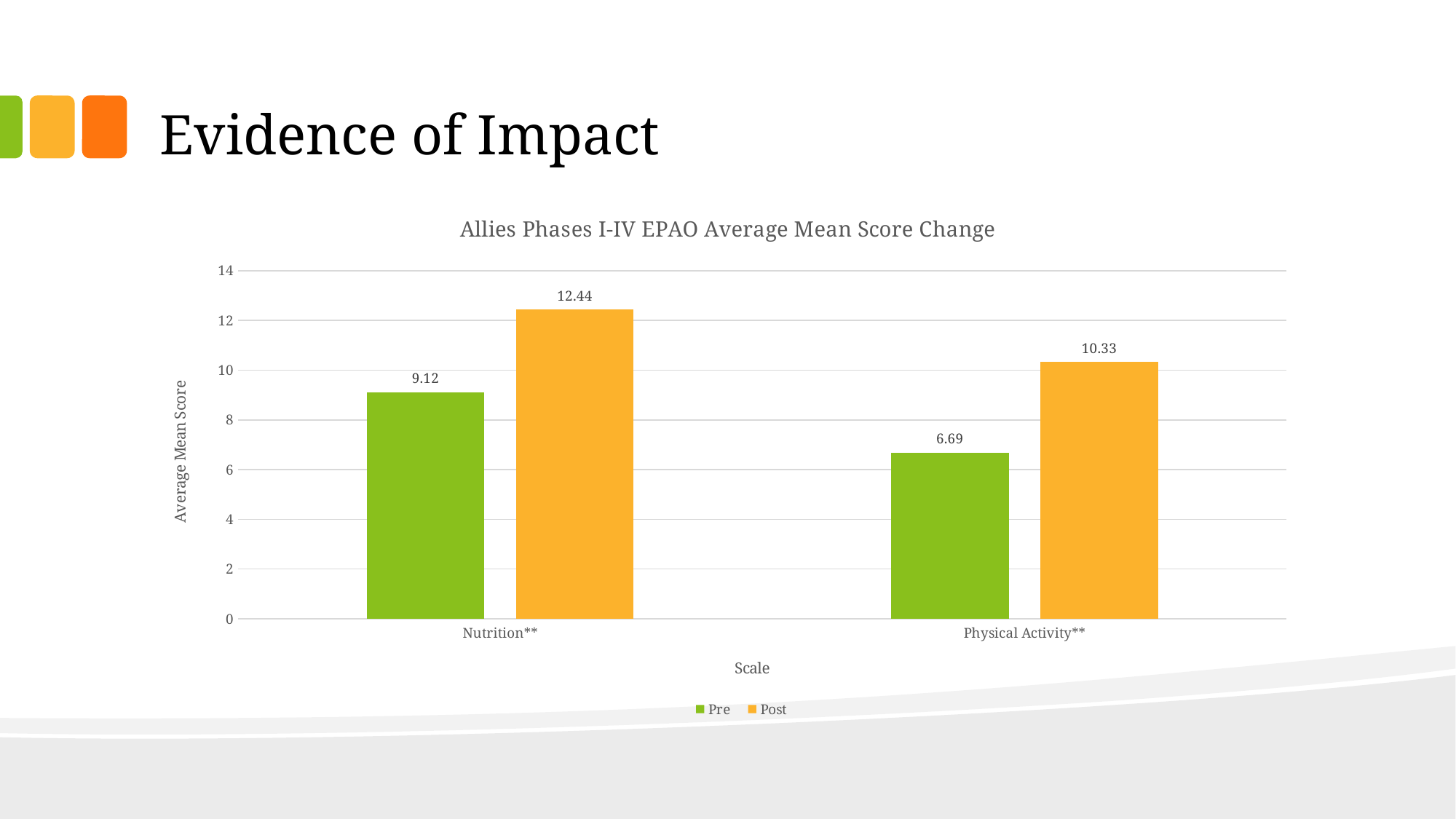
How many series does the legend list? 2 What is the Post value for Physical Activity**? 10.33 What is the difference between the Post and Pre values for Nutrition**? 3.32 Which is larger, the Pre value for Nutrition** or the Post value for Physical Activity**? Post value for Physical Activity** What is the Pre value for Nutrition**? 9.12 Which category has the lowest Pre value? Physical Activity** What is the difference between the Post and Pre values for Physical Activity**? 3.64 What is the Post value for Nutrition**? 12.44 What is the Pre value for Physical Activity**? 6.69 What is the title of the chart? Allies Phases I-IV EPAO Average Mean Score Change Which category has the highest Post value? Nutrition** How many categories are shown on the x axis? 2